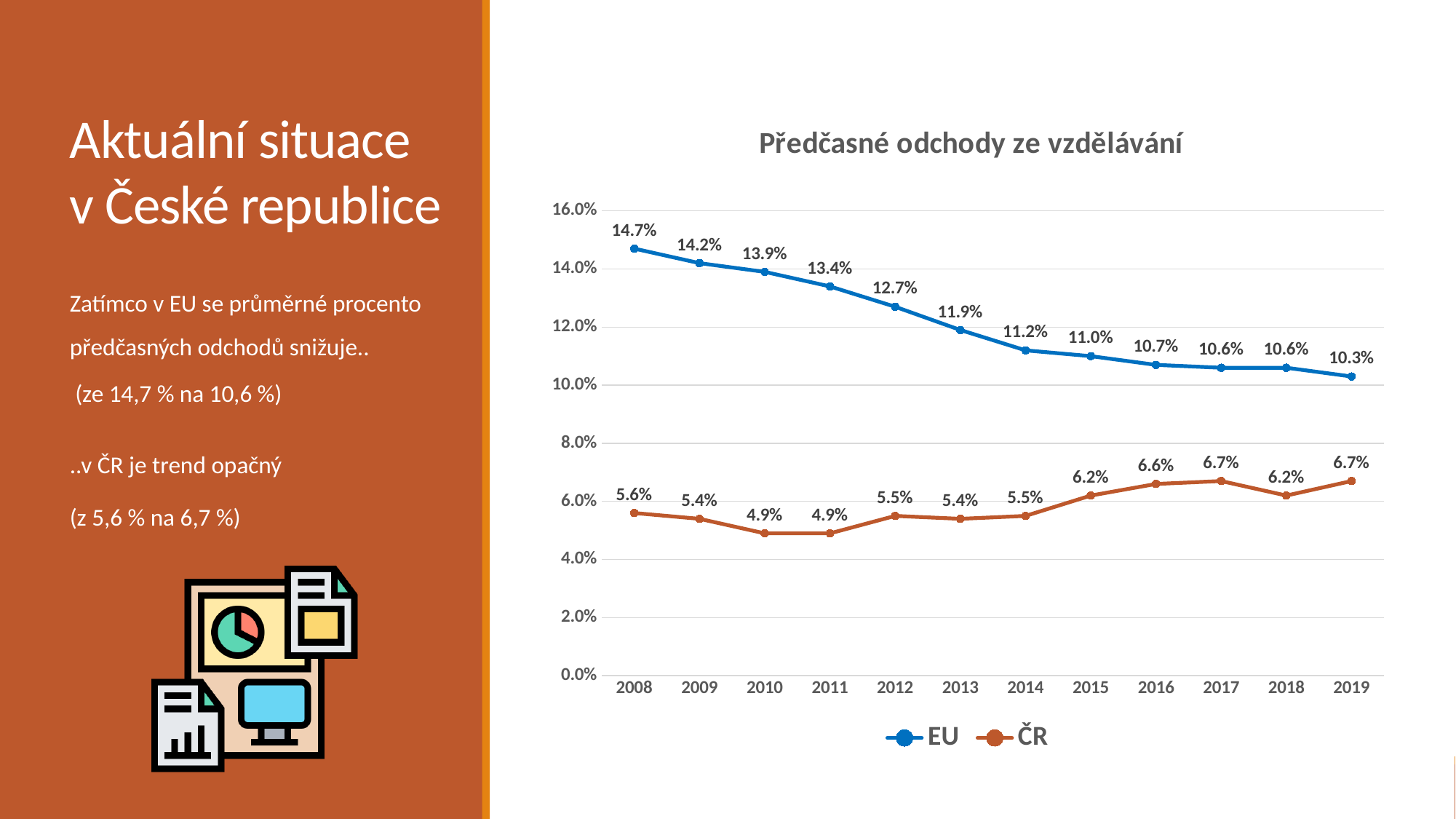
What is the ČR value for 2010? 4.9% What is the EU value for 2014? 11.2% Does the EU series rise or fall from 2008 to 2019? Fall How many series does the legend list? 2 What is the EU value for 2008? 14.7% In which year is the ČR series at its lowest value of 4.9%, the first time it reaches it? 2010 How many years are shown on the x axis? 12 Which series has the higher value in 2019, EU or ČR? EU What kind of chart is shown? Line chart What is the difference between the EU and ČR values in 2008? 9.1% What is the ČR value for 2019? 6.7% In which year is the EU series at its lowest? 2019